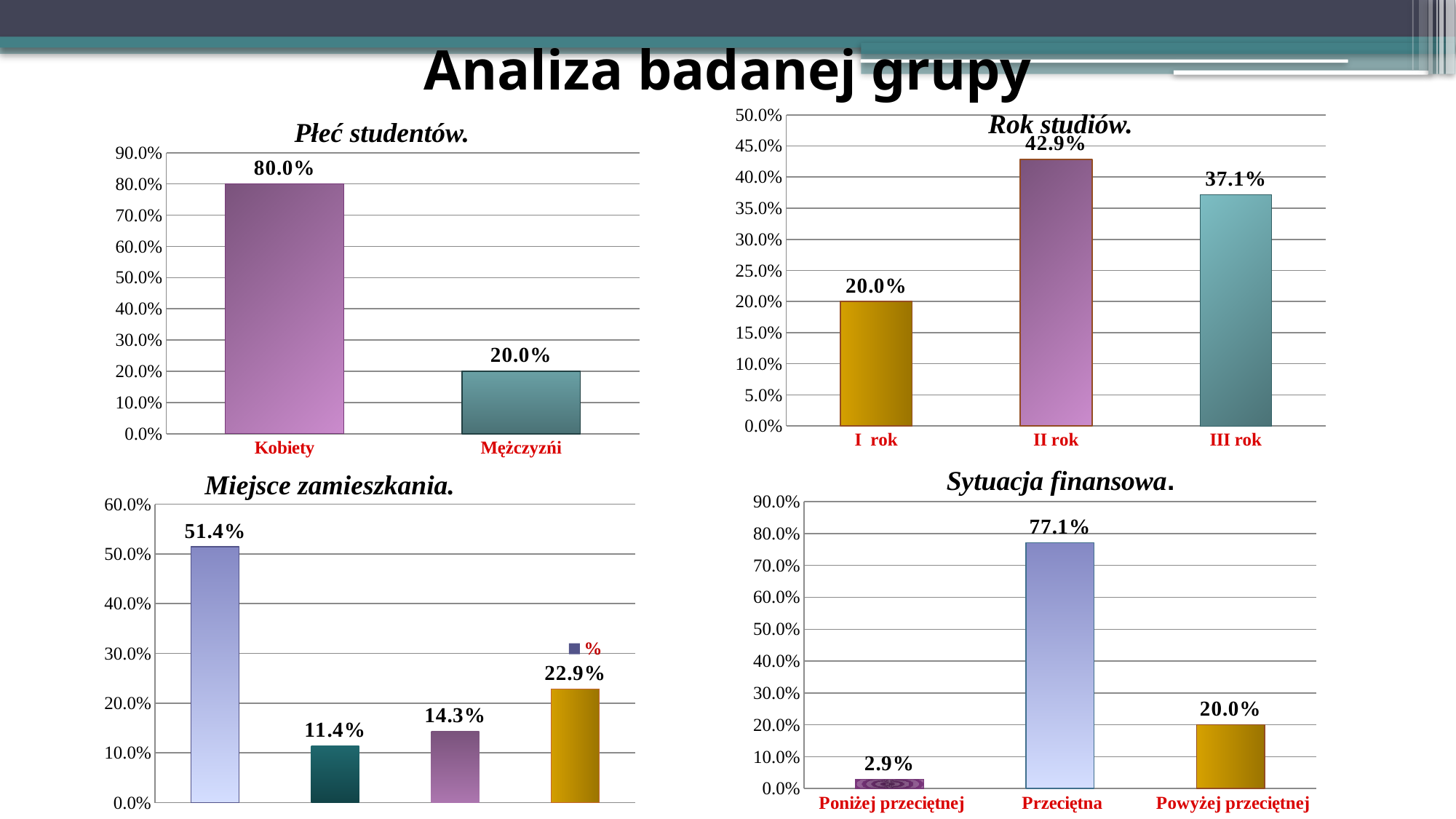
What kind of chart is the "Sytuacja finansowa." chart? Bar chart In the "Rok studiów." chart, which category has the highest value? II rok In the "Sytuacja finansowa." chart, which is larger: Poniżej przeciętnej or Powyżej przeciętnej? Powyżej przeciętnej In the "Miejsce zamieszkania." chart, how many bars are shown? 4 In the "Rok studiów." chart, which category has the lowest value? I rok In the "Płeć studentów." chart, what is the difference between the values for Kobiety and Mężczyźni? 60.0% In the "Płeć studentów." chart, what is the value for Kobiety? 80.0% In the "Miejsce zamieszkania." chart, what is the highest value shown? 51.4% In the "Rok studiów." chart, how many categories are shown? 3 In the "Sytuacja finansowa." chart, what is the value for Przeciętna? 77.1% In the "Miejsce zamieszkania." chart, what entry does the legend list? % In the "Rok studiów." chart, what is the value for III rok? 37.1%